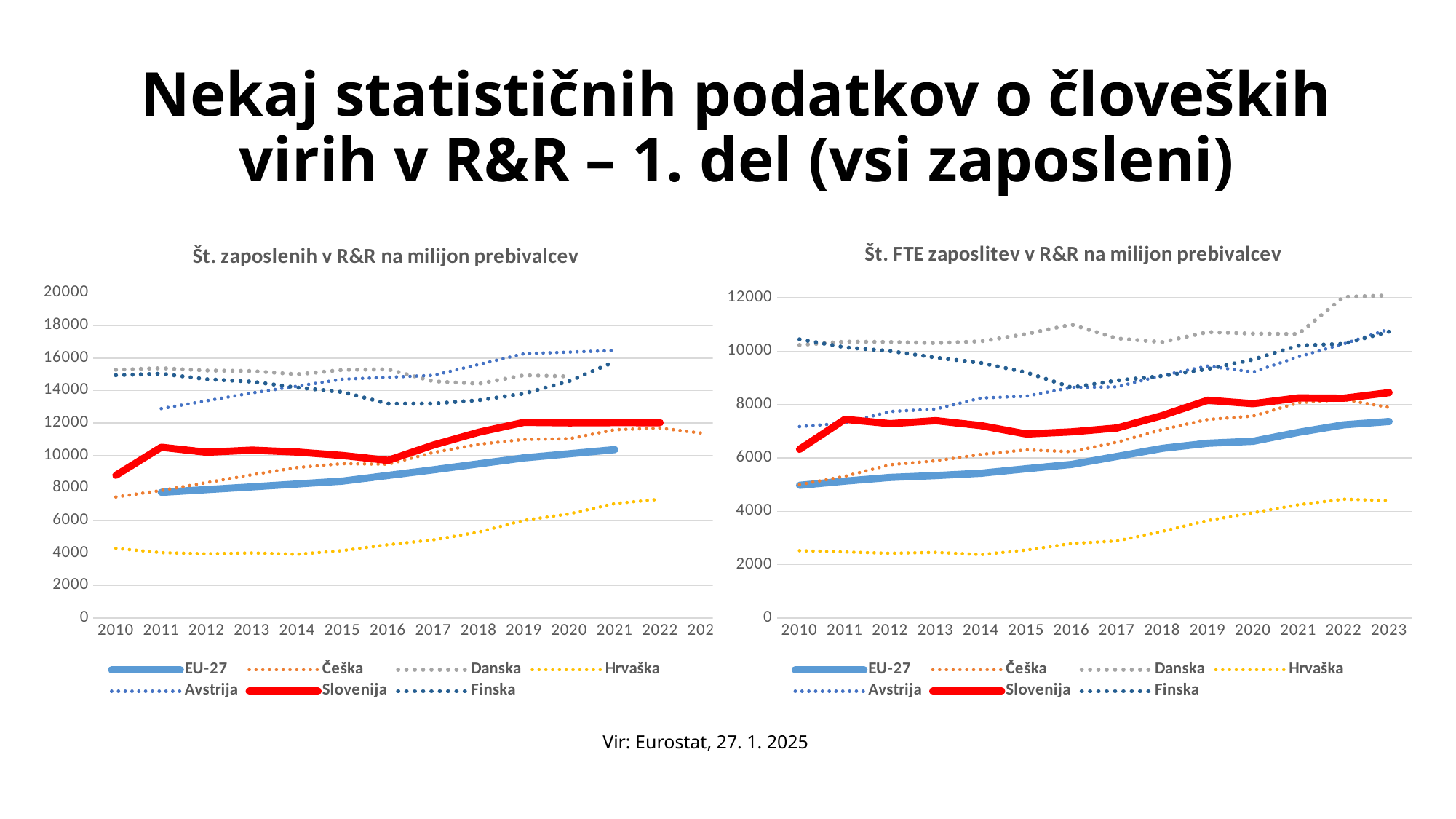
In the left chart 'Št. zaposlenih v R&R na milijon prebivalcev', is the value for Slovenija in 2010 greater or less than 8000? greater What kind of chart is the left chart, 'Št. zaposlenih v R&R na milijon prebivalcev'? line chart In the right chart 'Št. FTE zaposlitev v R&R na milijon prebivalcev', is the value for Hrvaška in 2010 greater or less than 4000? less In the right chart 'Št. FTE zaposlitev v R&R na milijon prebivalcev', which is larger in 2023, Slovenija or EU-27? Slovenija In the right chart 'Št. FTE zaposlitev v R&R na milijon prebivalcev', does the EU-27 line rise or fall from 2010 to 2023? rise In the right chart 'Št. FTE zaposlitev v R&R na milijon prebivalcev', which series has the highest value in 2023? Danska In the left chart 'Št. zaposlenih v R&R na milijon prebivalcev', does the Finska line rise or fall from 2010 to 2016? fall In the left chart 'Št. zaposlenih v R&R na milijon prebivalcev', is the value for Hrvaška in 2022 greater or less than 6000? greater How many years are shown on the x axis of the right chart 'Št. FTE zaposlitev v R&R na milijon prebivalcev'? 14 How many series does the legend of the left chart 'Št. zaposlenih v R&R na milijon prebivalcev' list? 7 In the left chart 'Št. zaposlenih v R&R na milijon prebivalcev', which series has the lowest value in 2010? Hrvaška